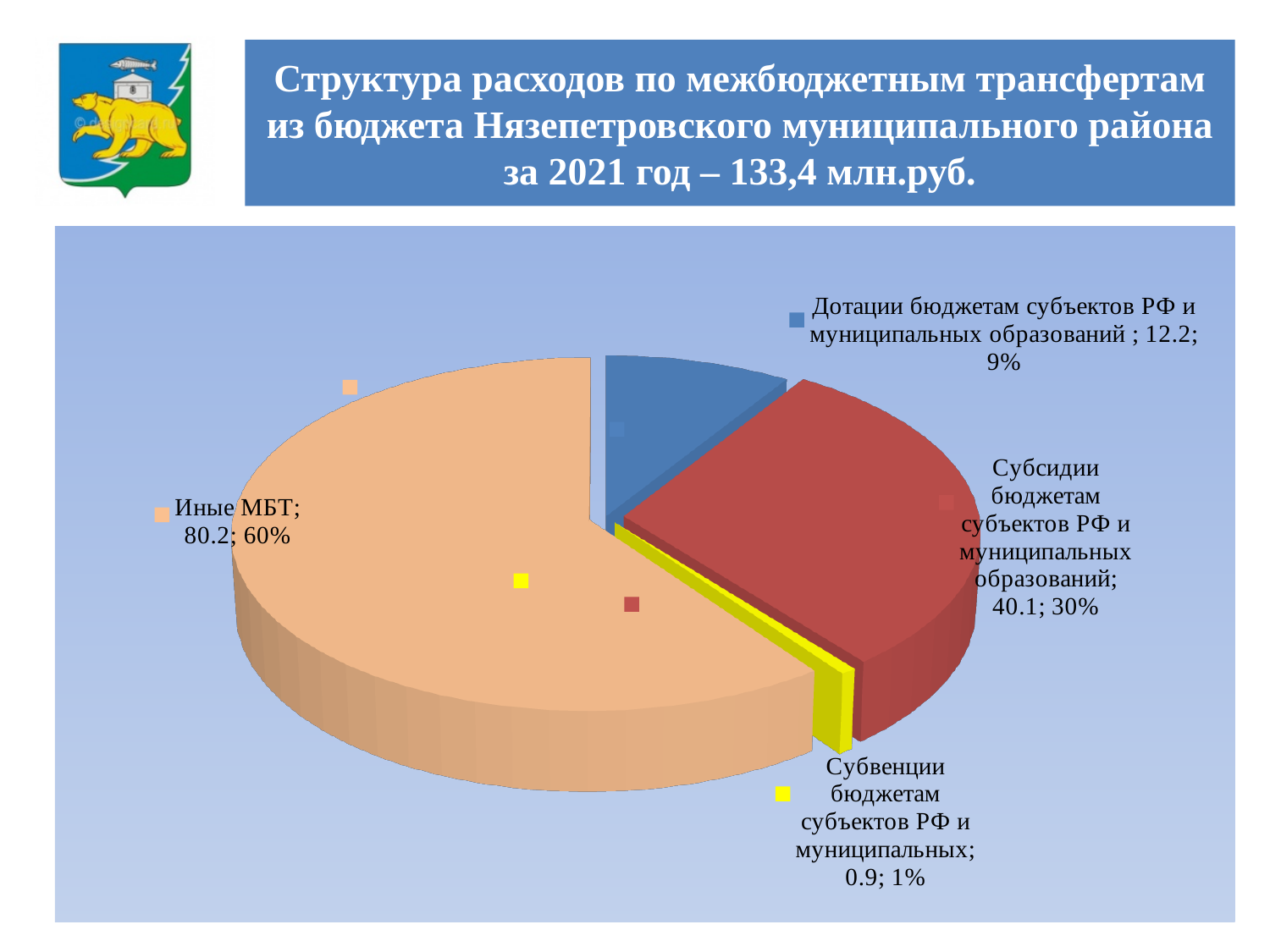
Which category has the smallest slice? Субвенции бюджетам субъектов РФ и муниципальных образований How many slices does the pie chart have? 4 What share of the pie does Иные МБТ represent? 60% What is the value for Дотации бюджетам субъектов РФ и муниципальных образований? 12.2 What is the value for Субсидии бюджетам субъектов РФ и муниципальных образований? 40.1 What kind of chart is shown on the slide? pie chart Which is larger, the value for Дотации or the value for Субвенции? Дотации What is the difference between the values for Иные МБТ and Субсидии бюджетам субъектов РФ и муниципальных образований? 40.1 What share of the pie does Субсидии бюджетам субъектов РФ и муниципальных образований represent? 30% What is the value for Иные МБТ? 80.2 What is the value for Субвенции бюджетам субъектов РФ и муниципальных образований? 0.9 Which category has the largest slice? Иные МБТ